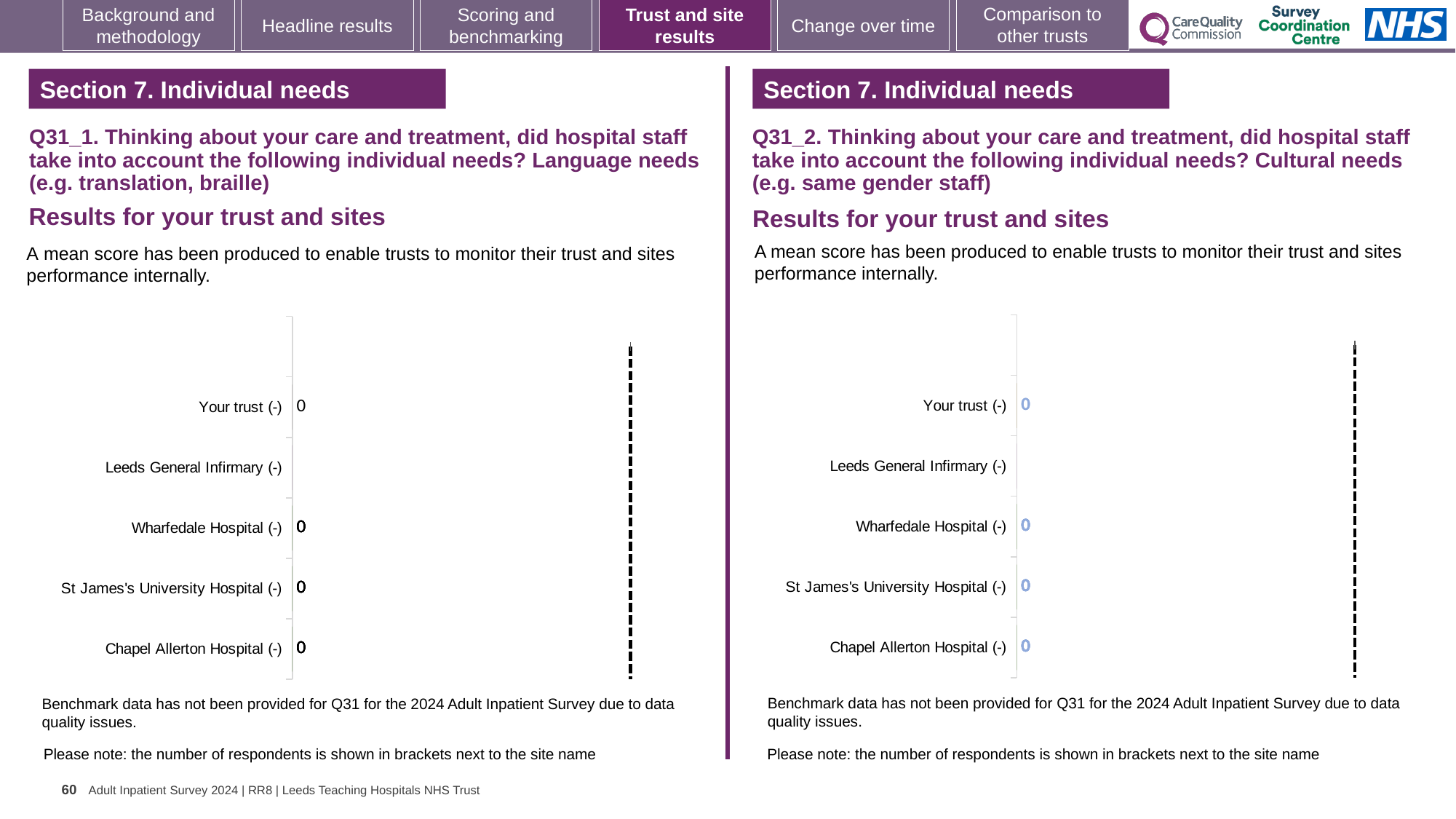
In the right chart (Q31_2, Cultural needs), what value is shown for St James's University Hospital? 0 What kind of chart is used for the Q31_1 results on the left of the slide? Bar chart In the left chart (Q31_1, Language needs), what value is shown for Your trust? 0 According to the note under the charts, why has benchmark data not been provided for Q31? Due to data quality issues How many categories are listed on the vertical axis of the left chart (Q31_1, Language needs)? 5 In the left chart (Q31_1, Language needs), what value is shown for Chapel Allerton Hospital? 0 In the left chart (Q31_1, Language needs), what value is shown for Wharfedale Hospital? 0 In the right chart (Q31_2, Cultural needs), what value is shown for Your trust? 0 In the left chart (Q31_1, Language needs), which category has no data label printed next to it? Leeds General Infirmary (-) How many categories are listed on the vertical axis of the right chart (Q31_2, Cultural needs)? 5